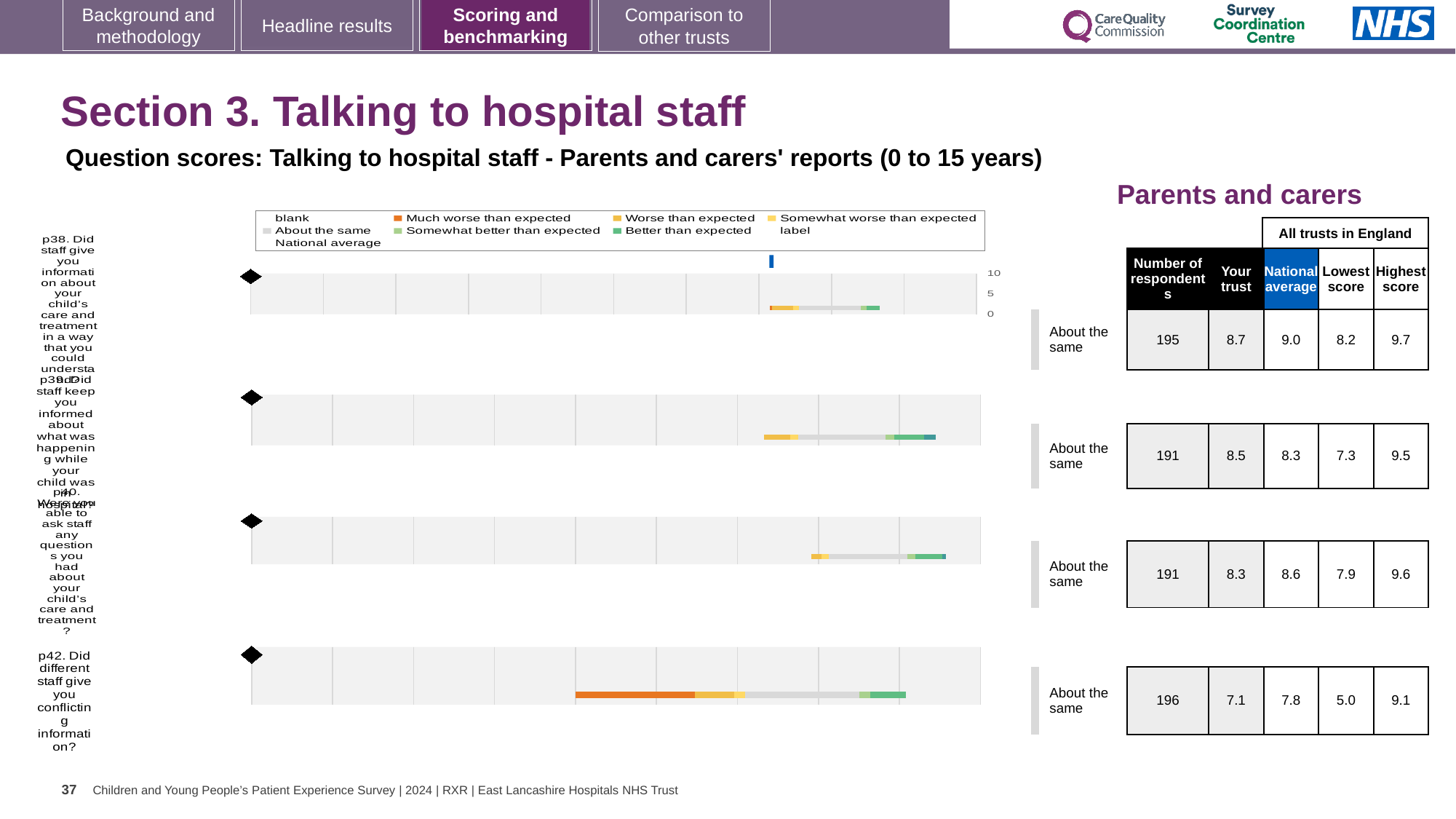
What is the difference between the highest score and the lowest score across all trusts in England for p42? 4.1 What is the national average score for p42 (Did different staff give you conflicting information)? 7.8 What colour does the legend use for 'Much worse than expected'? orange What benchmark category is shown for p40 (Were you able to ask staff any questions you had about your child's care and treatment)? About the same What kind of chart is used to show the question scores on this slide? bar chart Which question has the highest 'Your trust' score? p38 For p39, which is larger: the 'Your trust' score or the national average? Your trust How many respondents answered p42? 196 How many questions (p38, p39, p40, p42) are plotted as bars on the slide? 4 By how much does the national average exceed the 'Your trust' score for p38? 0.3 What is the 'Your trust' score for p38 (Did staff give you information about your child's care and treatment in a way that you could understand)? 8.7 Which question has the lowest 'Your trust' score? p42